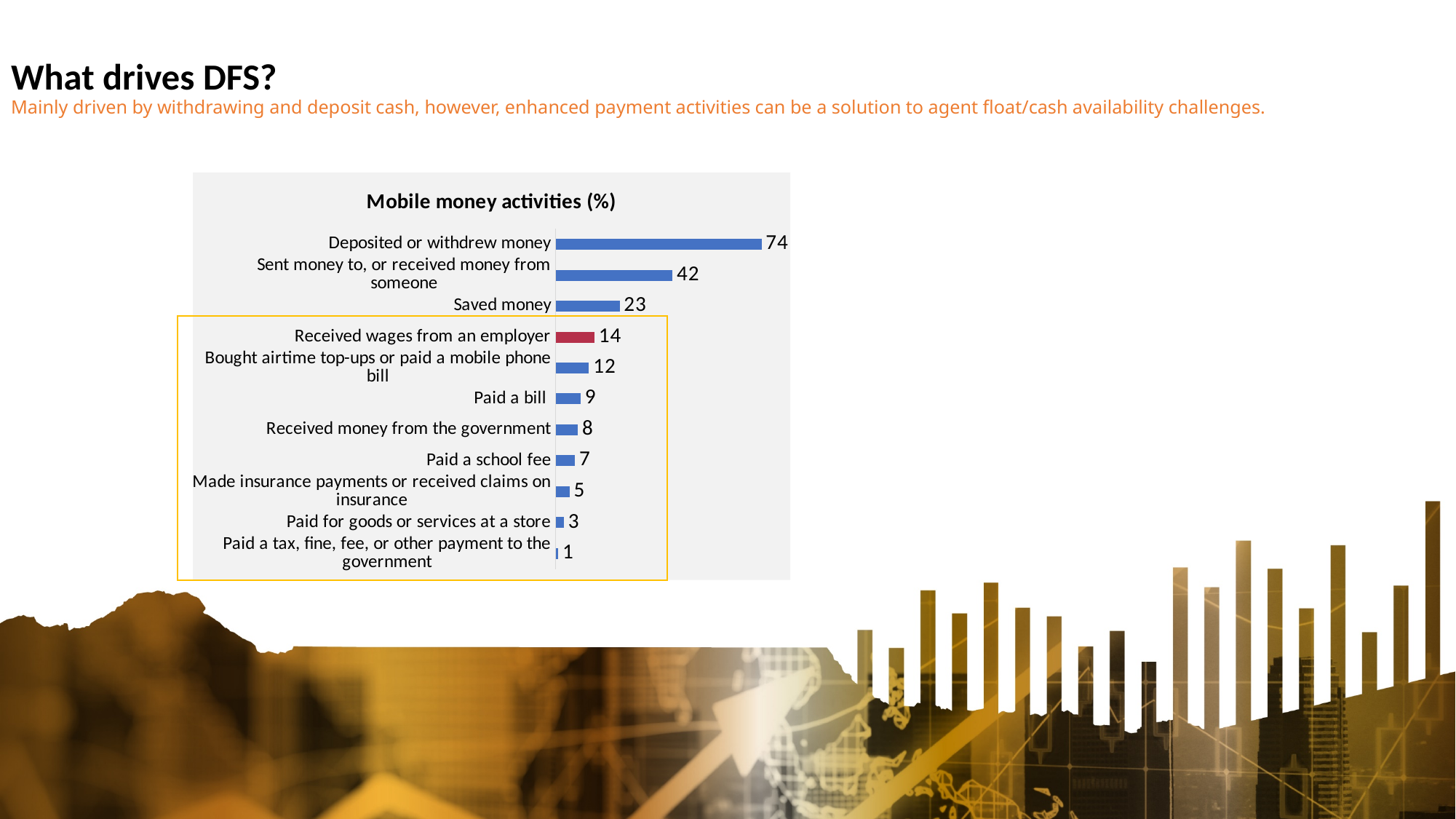
What is the value for "Received wages from an employer"? 14 Which activity has the highest value? Deposited or withdrew money Which bar is coloured red instead of blue? Received wages from an employer What kind of chart is shown? Bar chart How many activities are shown in the chart? 11 What is the value for "Deposited or withdrew money"? 74 Which is larger: "Paid a bill" or "Received money from the government"? Paid a bill What is the difference between "Deposited or withdrew money" and "Sent money to, or received money from someone"? 32 What is the value for "Paid a school fee"? 7 What is the value for "Saved money"? 23 Which activity has the lowest value? Paid a tax, fine, fee, or other payment to the government What is the title of the chart? Mobile money activities (%)